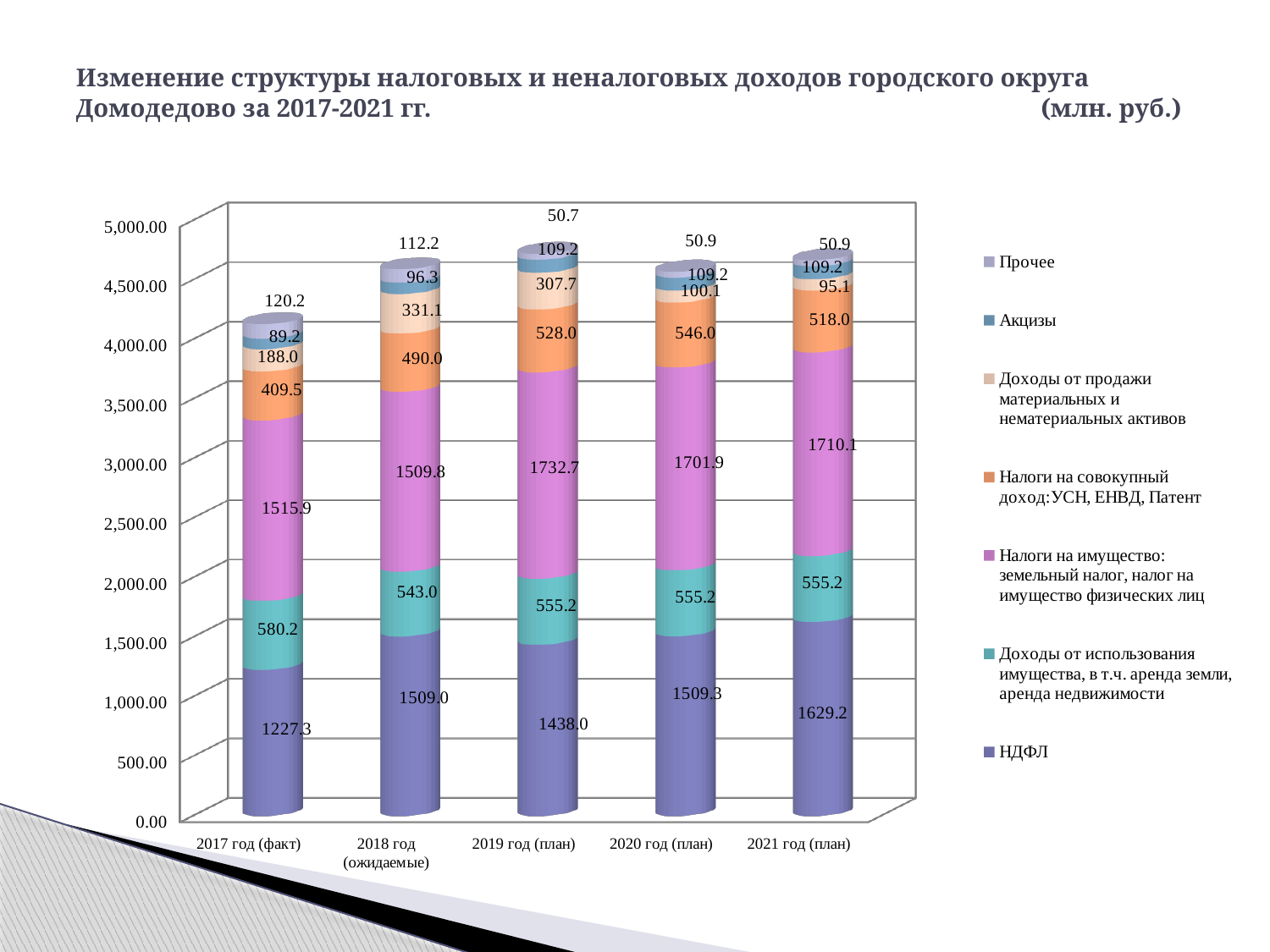
Which is larger: Налоги на совокупный доход for 2020 год (план) or for 2021 год (план)? 2020 год (план) What is the value of Прочее for 2021 год (план)? 50.9 What is the total of the stacked bar for 2017 год (факт)? 4130.3 How many year categories are shown on the x axis? 5 In which year is the НДФЛ value the lowest? 2017 год (факт) In which year is the НДФЛ value the highest? 2021 год (план) What is the difference between the Налоги на имущество values for 2019 год (план) and 2017 год (факт)? 216.8 What type of chart is shown on the slide? stacked bar chart How many series does the legend list? 7 What is the value of Налоги на имущество for 2019 год (план)? 1732.7 What is the value of НДФЛ for 2017 год (факт)? 1227.3 What is the value of Доходы от продажи материальных и нематериальных активов for 2018 год (ожидаемые)? 331.1